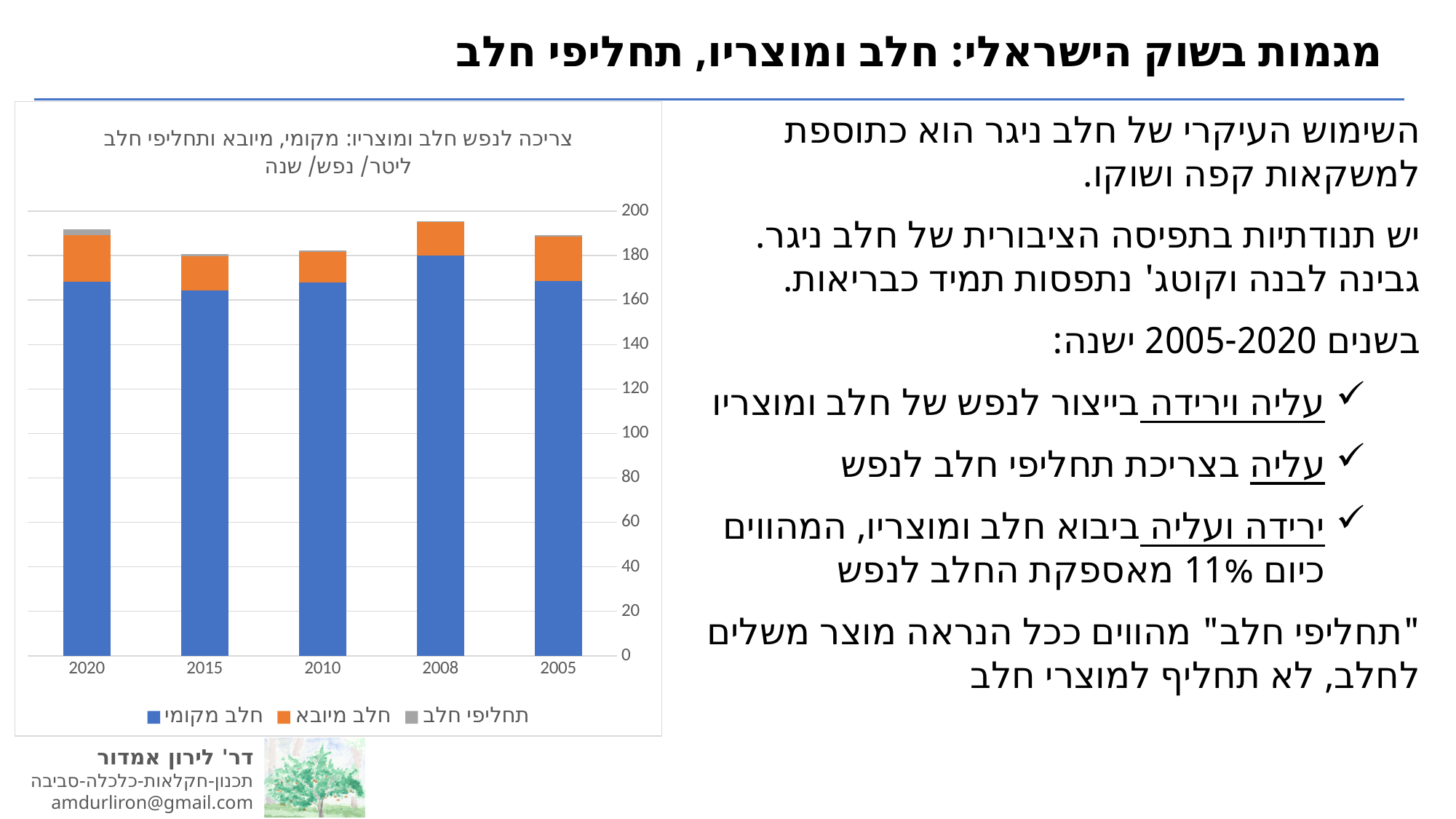
Which year has the tallest stacked bar (highest total consumption)? 2008 Which year has the highest value for חלב מקומי (the blue segment)? 2008 How many series does the chart legend list? 3 What kind of chart is shown on the slide? Stacked bar chart Is the total stacked bar for 2008 larger or smaller than the total for 2015? Larger In which year does the gray series (תחליפי חלב) visibly appear on the chart? 2020 Is the value for חלב מקומי in 2020 greater or less than 180? less Which series is shown in orange in the chart legend? חלב מיובא Is the total stacked bar for 2005 greater or less than 160? greater Is the value for חלב מקומי in 2008 greater or less than 160? greater How many years (categories) are shown on the x axis of the chart? 5